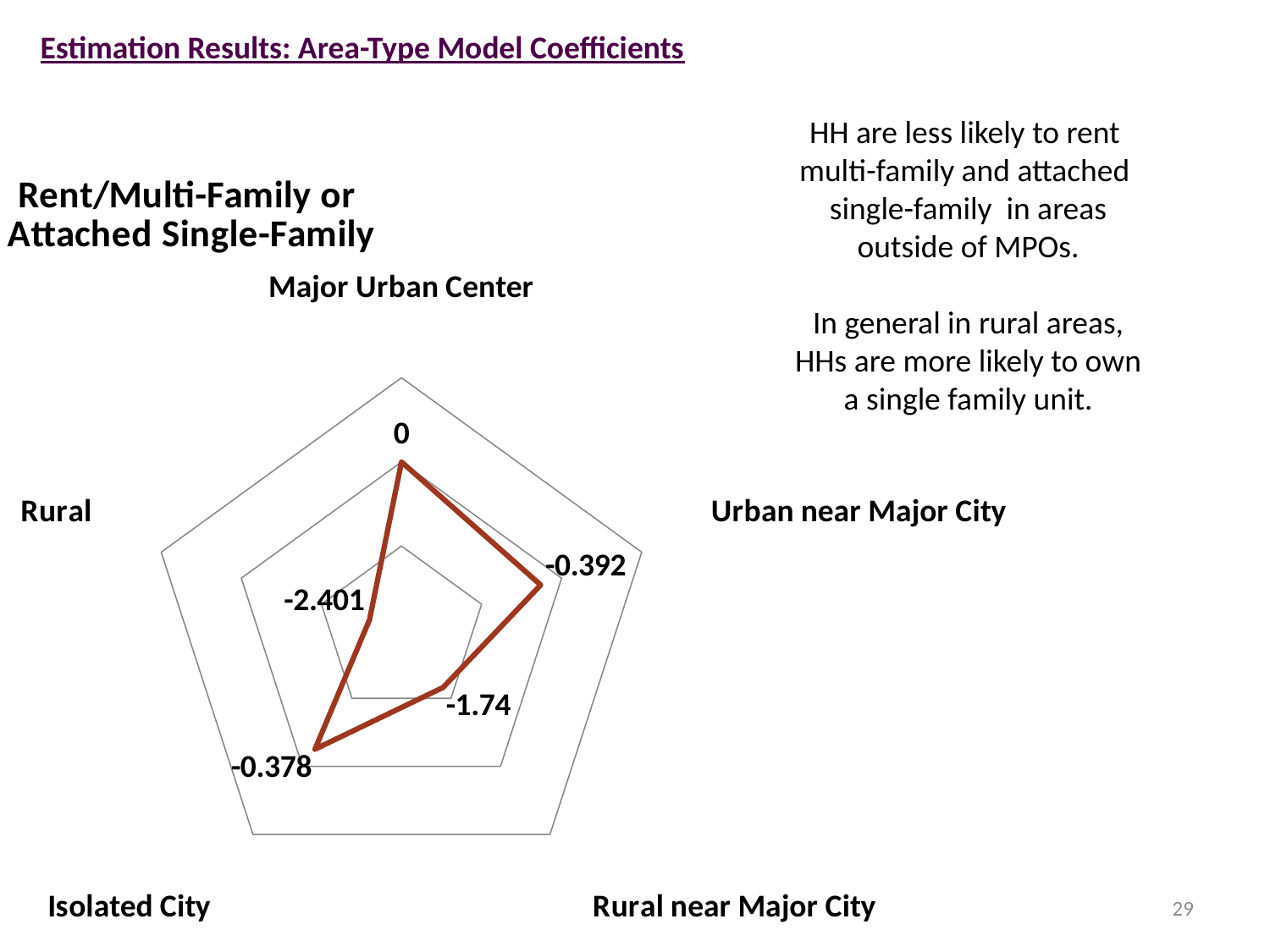
What is the coefficient value for Urban near Major City? -0.392 Which has a larger coefficient value, Urban near Major City or Rural near Major City? Urban near Major City What kind of chart is shown on the slide? Radar chart What is the coefficient value for Rural near Major City? -1.74 What is the difference between the coefficient for Rural and the coefficient for Rural near Major City? 0.661 How many area-type categories are plotted on the radar chart? 5 What is the coefficient value for Major Urban Center? 0 Which area type has the lowest coefficient value? Rural Which area type has the highest coefficient value? Major Urban Center What is the coefficient value for Rural? -2.401 What is the title of the radar chart? Rent/Multi-Family or Attached Single-Family What is the coefficient value for Isolated City? -0.378